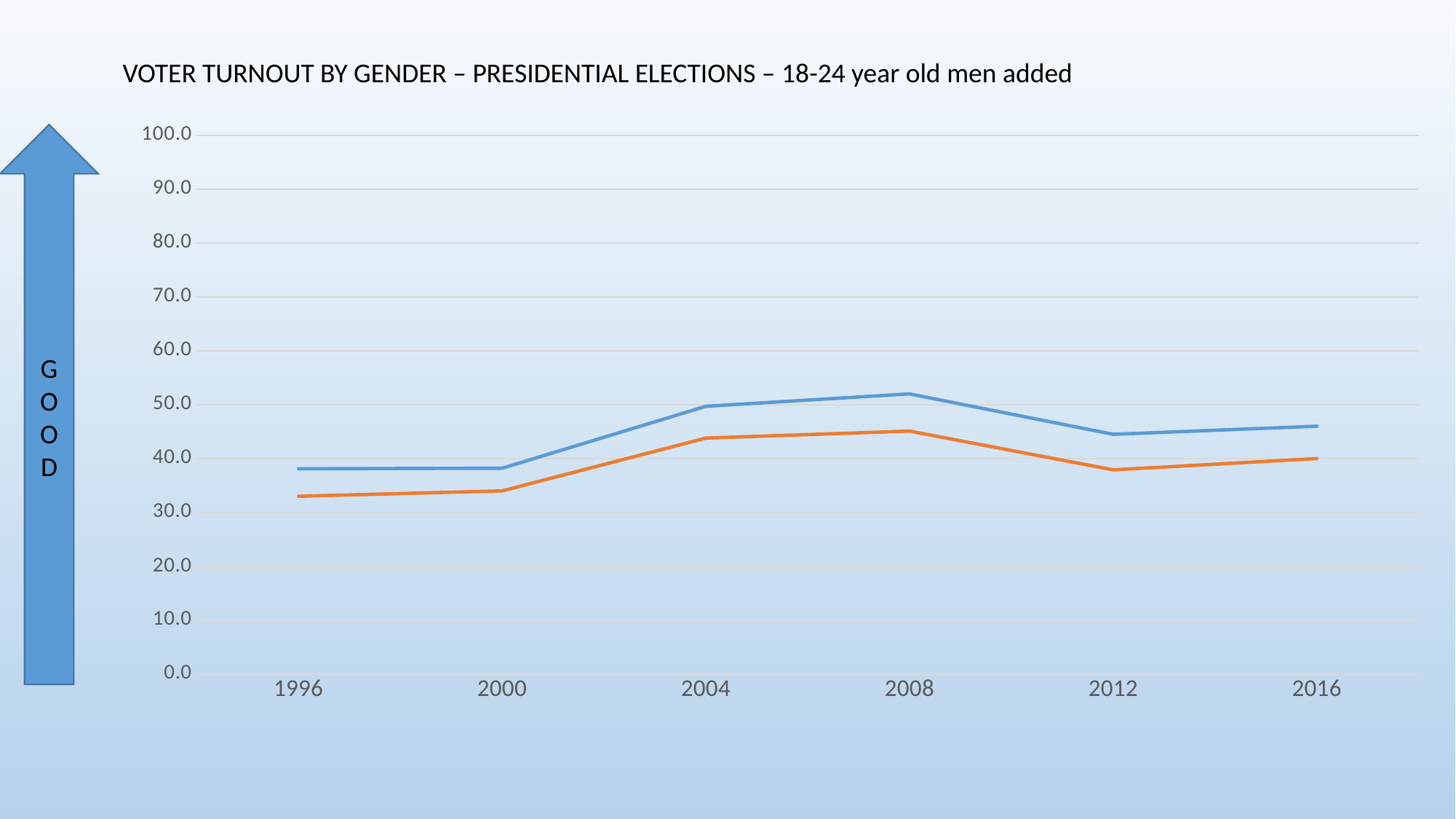
Is the value of the orange line in 2008 greater or less than 50.0? less Is the value of the blue line in 2004 greater or less than 40.0? greater Is the value of the orange line in 1996 greater or less than 40.0? less What is the title of the chart? VOTER TURNOUT BY GENDER – PRESIDENTIAL ELECTIONS – 18-24 year old men added In which year does the blue line reach its highest value? 2008 How many election years are shown on the x axis? 6 What kind of chart is shown on the slide? line chart Does the orange line rise or fall between 2008 and 2012? fall How many lines are plotted on the chart? 2 Does the blue line rise or fall between 2000 and 2004? rise In 2016, which line has the higher value, the blue line or the orange line? blue line